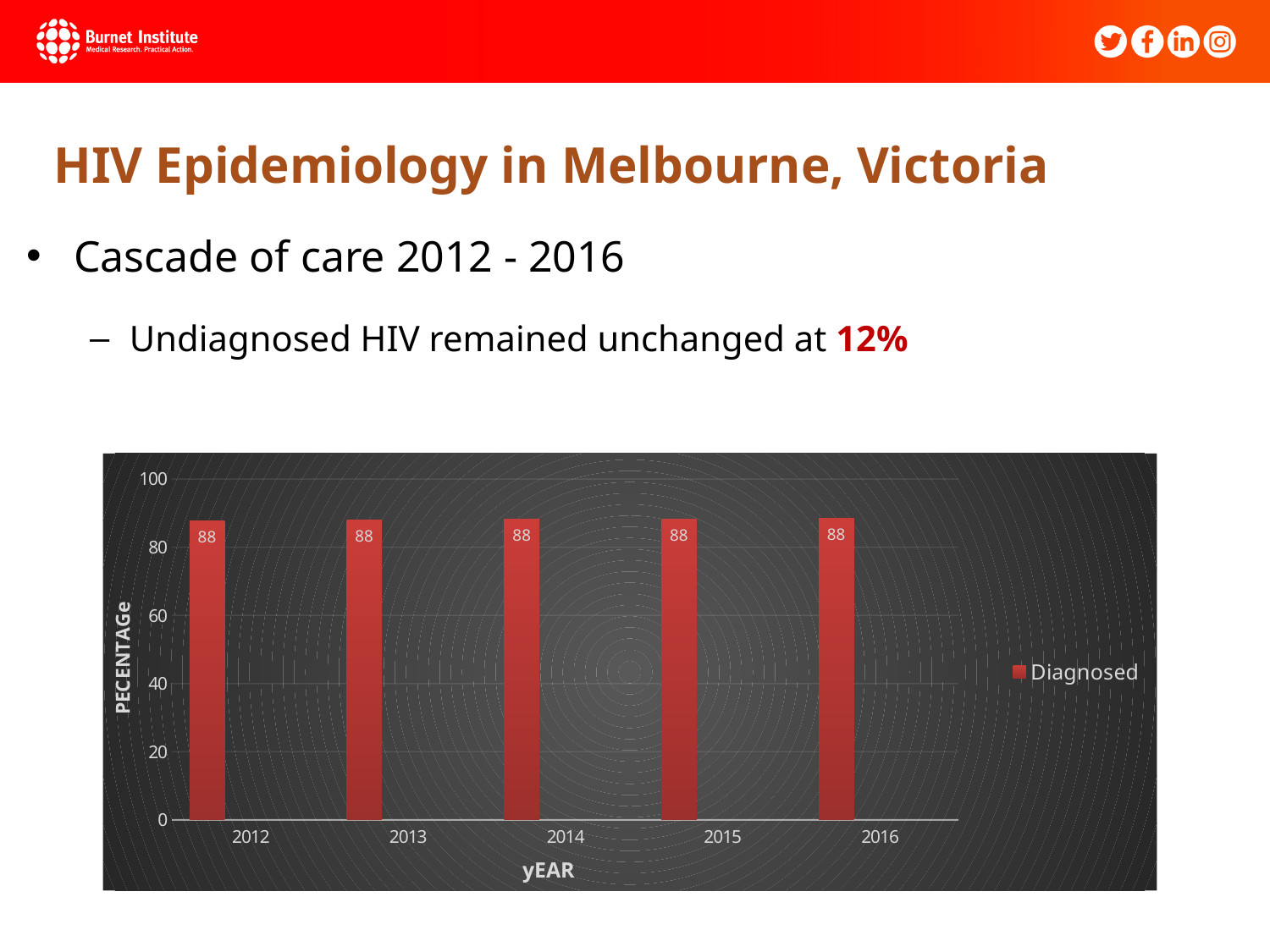
What kind of chart is shown on the slide? bar chart What is the Diagnosed value for 2016? 88 What is the title of the x axis of the chart? yEAR What is the label of the series shown in the chart legend? Diagnosed What is the difference between the Diagnosed values for 2013 and 2015? 0 Is the Diagnosed value for 2015 greater or less than 80? greater How many series does the chart legend list? 1 How many years are shown on the x axis of the chart? 5 What is the Diagnosed value for 2012? 88 What is the Diagnosed value for 2014? 88 Is the Diagnosed value for 2012 greater or less than 100? less Do the Diagnosed values rise, fall, or stay the same from 2012 to 2016? stay the same